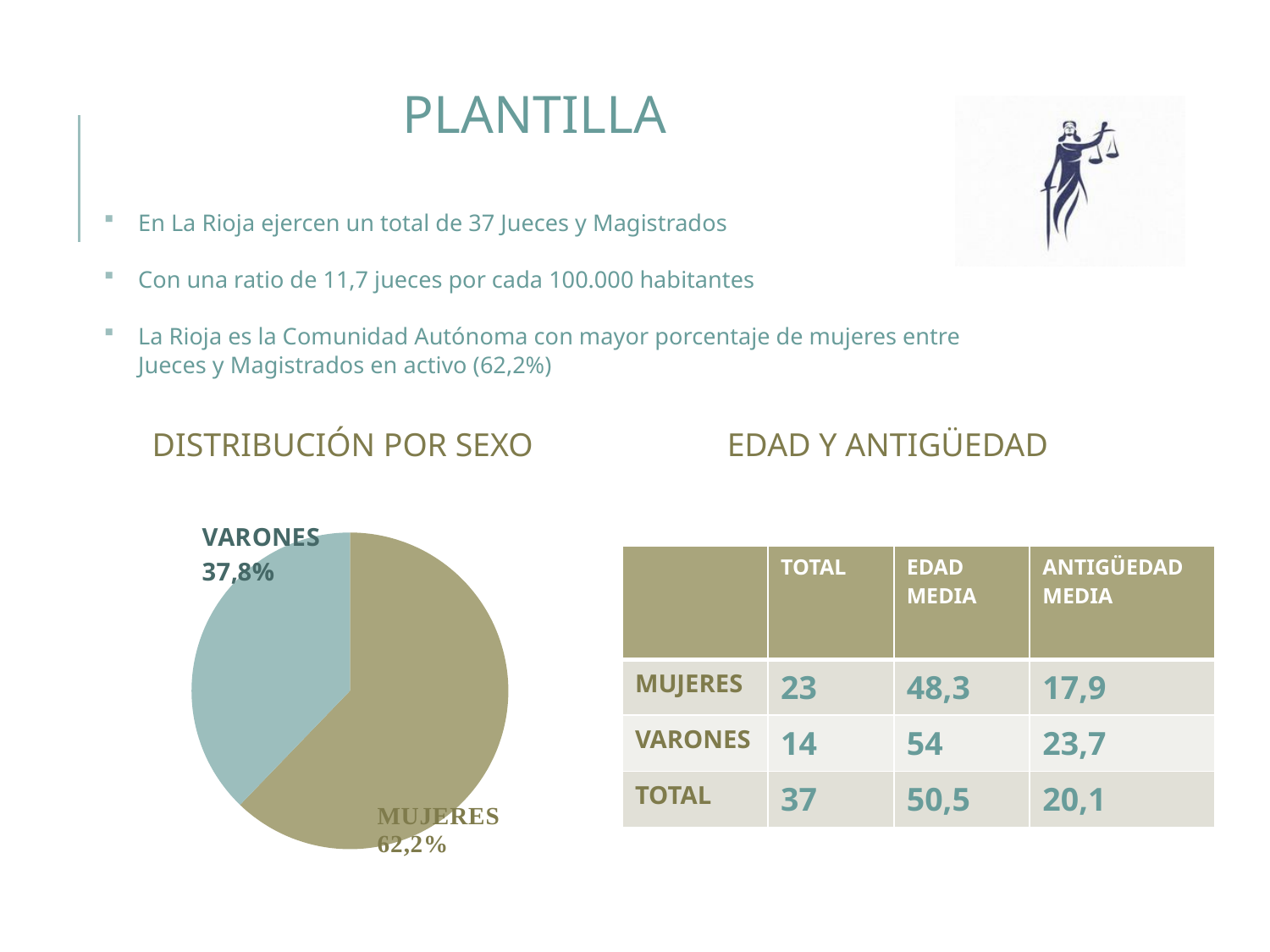
In the DISTRIBUCIÓN POR SEXO pie chart, what share is labelled for VARONES? 37,8% Which slice of the DISTRIBUCIÓN POR SEXO pie chart is the largest? MUJERES Is the MUJERES share in the DISTRIBUCIÓN POR SEXO pie chart greater or less than 50%? greater In the DISTRIBUCIÓN POR SEXO pie chart, which slice is coloured light blue-green? VARONES What kind of chart is shown under the heading DISTRIBUCIÓN POR SEXO? Pie chart Which slice of the DISTRIBUCIÓN POR SEXO pie chart is the smallest? VARONES How many slices does the DISTRIBUCIÓN POR SEXO pie chart have? 2 What is the heading above the pie chart on the slide? DISTRIBUCIÓN POR SEXO In the DISTRIBUCIÓN POR SEXO pie chart, what is the difference in percentage points between the MUJERES and VARONES shares? 24,4 In the DISTRIBUCIÓN POR SEXO pie chart, what share is labelled for MUJERES? 62,2% Is the VARONES share in the DISTRIBUCIÓN POR SEXO pie chart greater or less than 50%? less In the DISTRIBUCIÓN POR SEXO pie chart, which is larger, the MUJERES slice or the VARONES slice? MUJERES